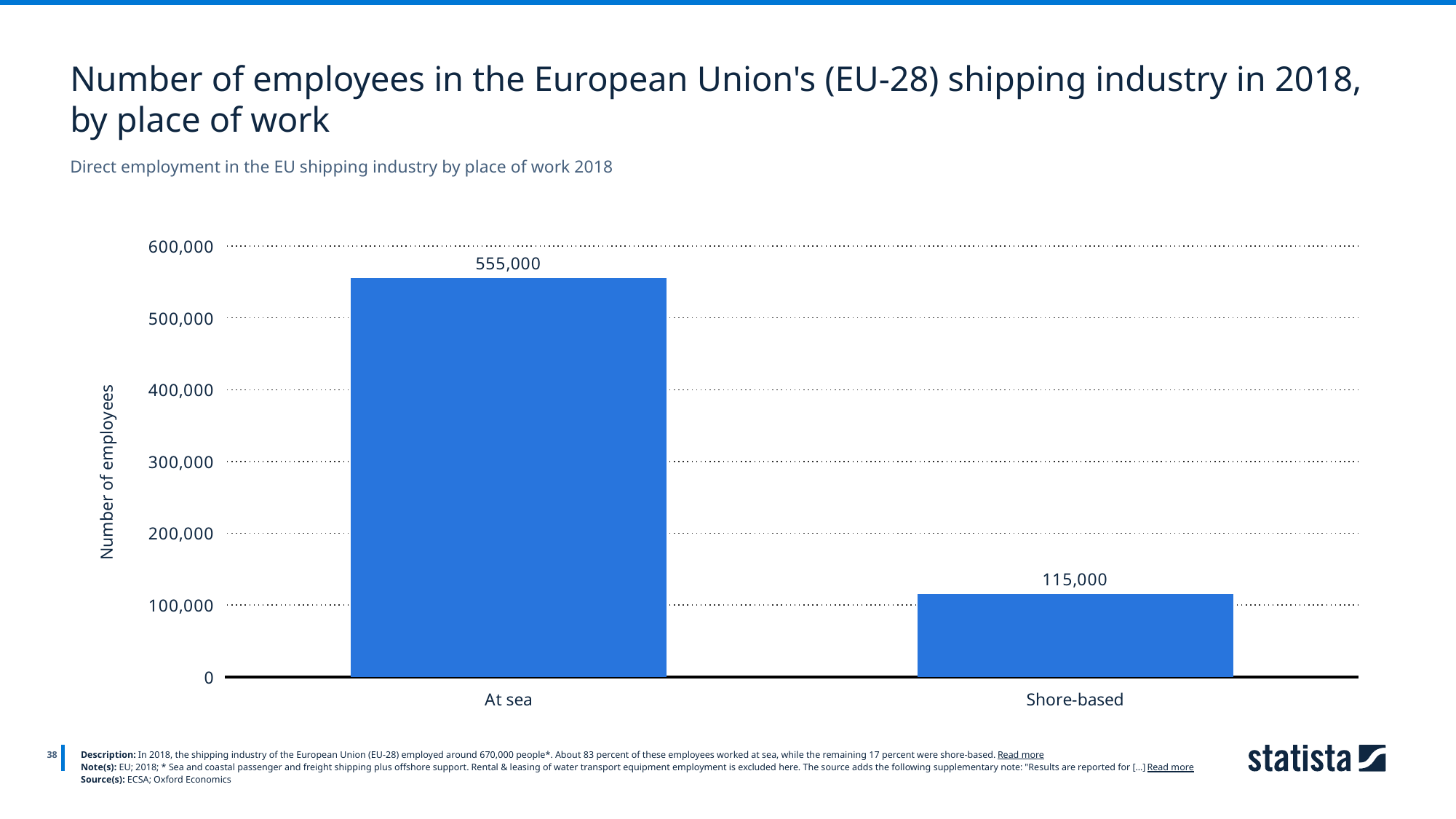
Which place of work has the lowest number of employees? Shore-based What is the label of the y axis? Number of employees What is the difference between the number of employees at sea and shore-based? 440,000 What is the number of shore-based employees? 115,000 What is the number of employees at sea? 555,000 Is the value for Shore-based greater or less than 200,000? less What is the subtitle of the chart? Direct employment in the EU shipping industry by place of work 2018 Which place of work has the highest number of employees? At sea What kind of chart is shown on the slide? Bar chart Which has more employees, at sea or shore-based? At sea How many categories are shown on the chart? 2 Is the value for At sea greater or less than 500,000? greater